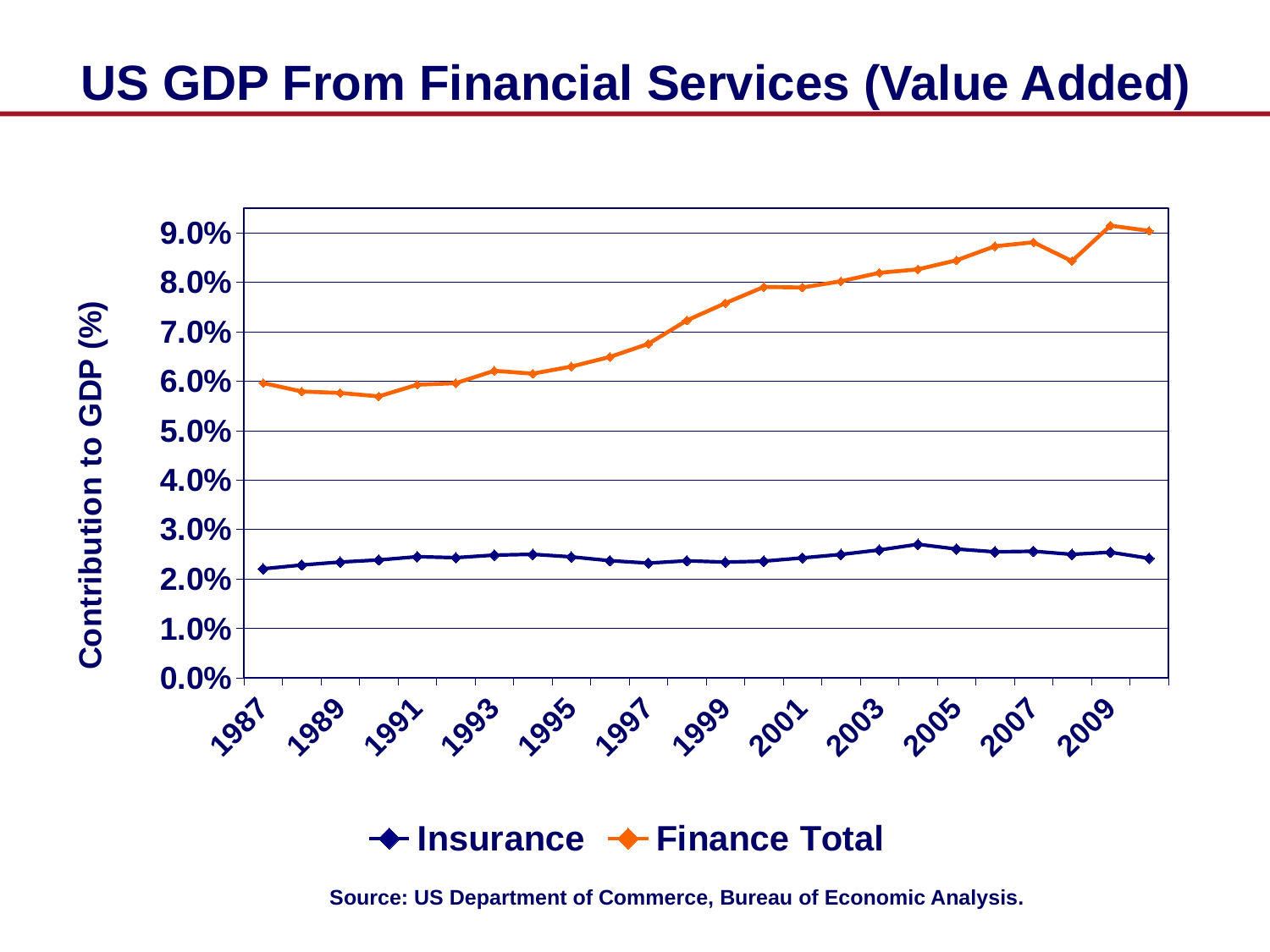
Is the Insurance value for 2005 greater or less than 2.0%? greater In 2001, which series has the larger value, Insurance or Finance Total? Finance Total What are the two series named in the legend? Insurance and Finance Total Is the Finance Total value for 1987 greater or less than 5.0%? greater What kind of chart is shown on the slide? line chart How many series does the legend list? 2 Does the Finance Total series generally rise or fall from 1987 to 2009? rise Is the Insurance value for 1987 greater or less than 3.0%? less Which series stays below 3.0% across all years shown? Insurance What is the label on the vertical axis? Contribution to GDP (%)